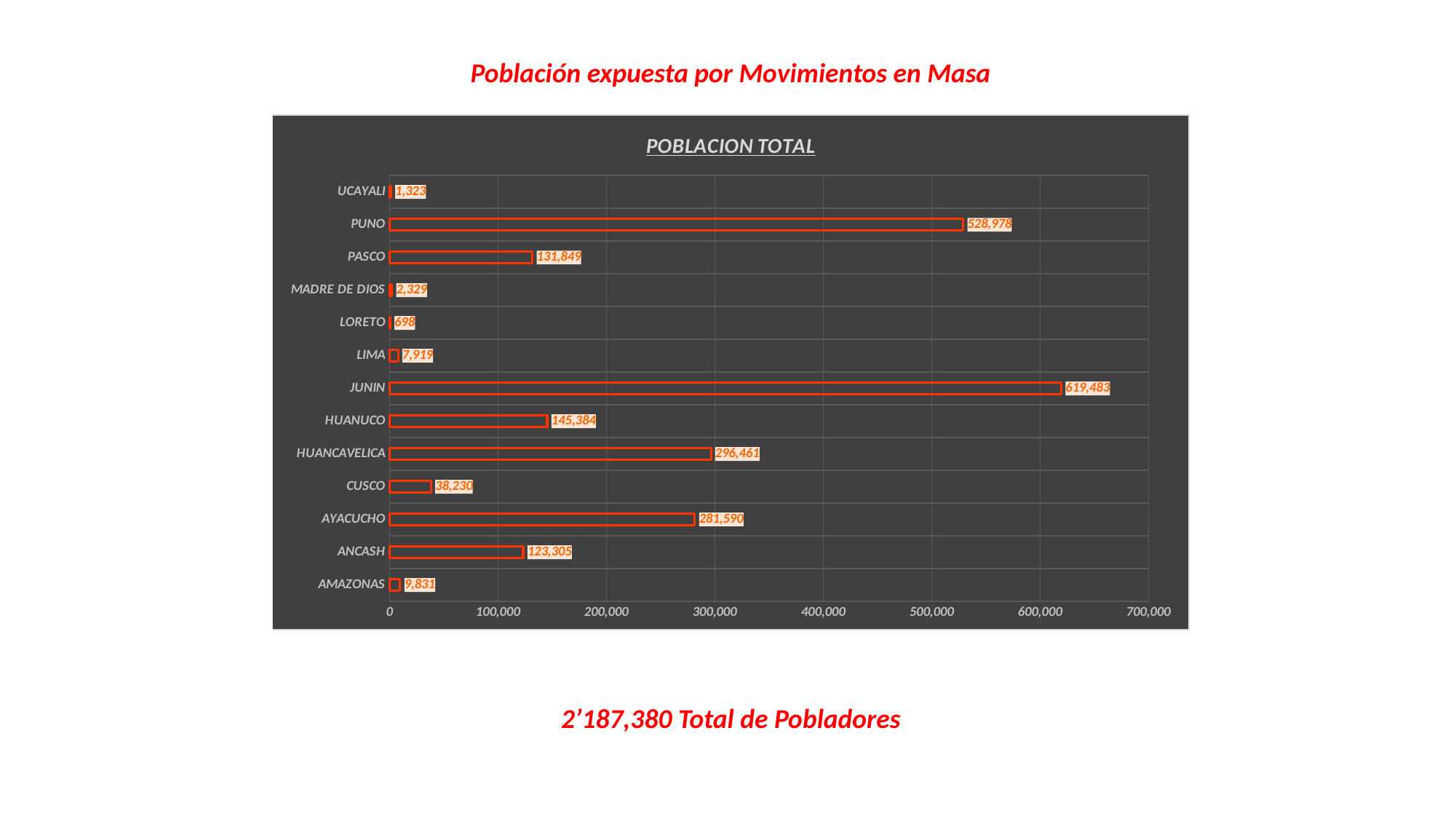
How many categories are shown in the chart? 13 Is the value for PUNO greater or less than 500,000? greater What kind of chart is shown on the slide? Bar chart Which category has the highest value? JUNIN What is the value for CUSCO? 38,230 Which category has the lowest value? LORETO What is the value for HUANCAVELICA? 296,461 What is the difference between the values for JUNIN and PUNO? 90,505 What is the value for JUNIN? 619,483 What is the difference between the values for HUANCAVELICA and AYACUCHO? 14,871 Which is larger, the value for HUANUCO or the value for PASCO? HUANUCO What is the value for LORETO? 698